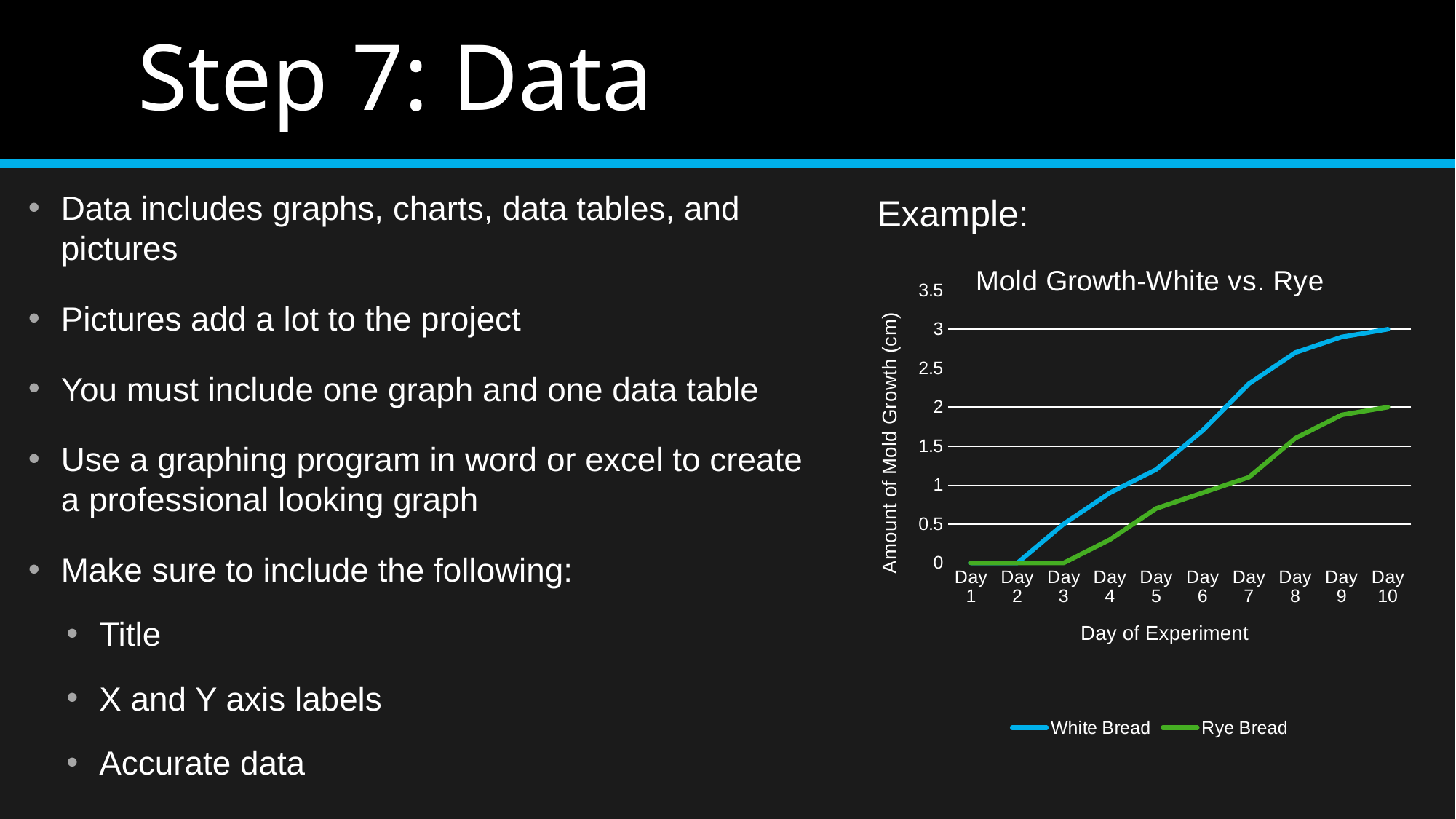
What is the label on the y axis of the chart? Amount of Mold Growth (cm) What is the value for White Bread on Day 10? 3 Which series has the higher value on Day 7, White Bread or Rye Bread? White Bread How many series does the chart legend list? 2 How many days are plotted along the x axis of the chart? 10 What is the value for Rye Bread on Day 1? 0 What kind of chart is shown on the slide? line chart Do the White Bread values rise or fall from Day 1 to Day 10? rise What is the value for Rye Bread on Day 10? 2 Is the value for Rye Bread on Day 5 greater or less than 1? less Is the value for White Bread on Day 6 greater or less than 1? greater What is the title of the chart? Mold Growth-White vs. Rye